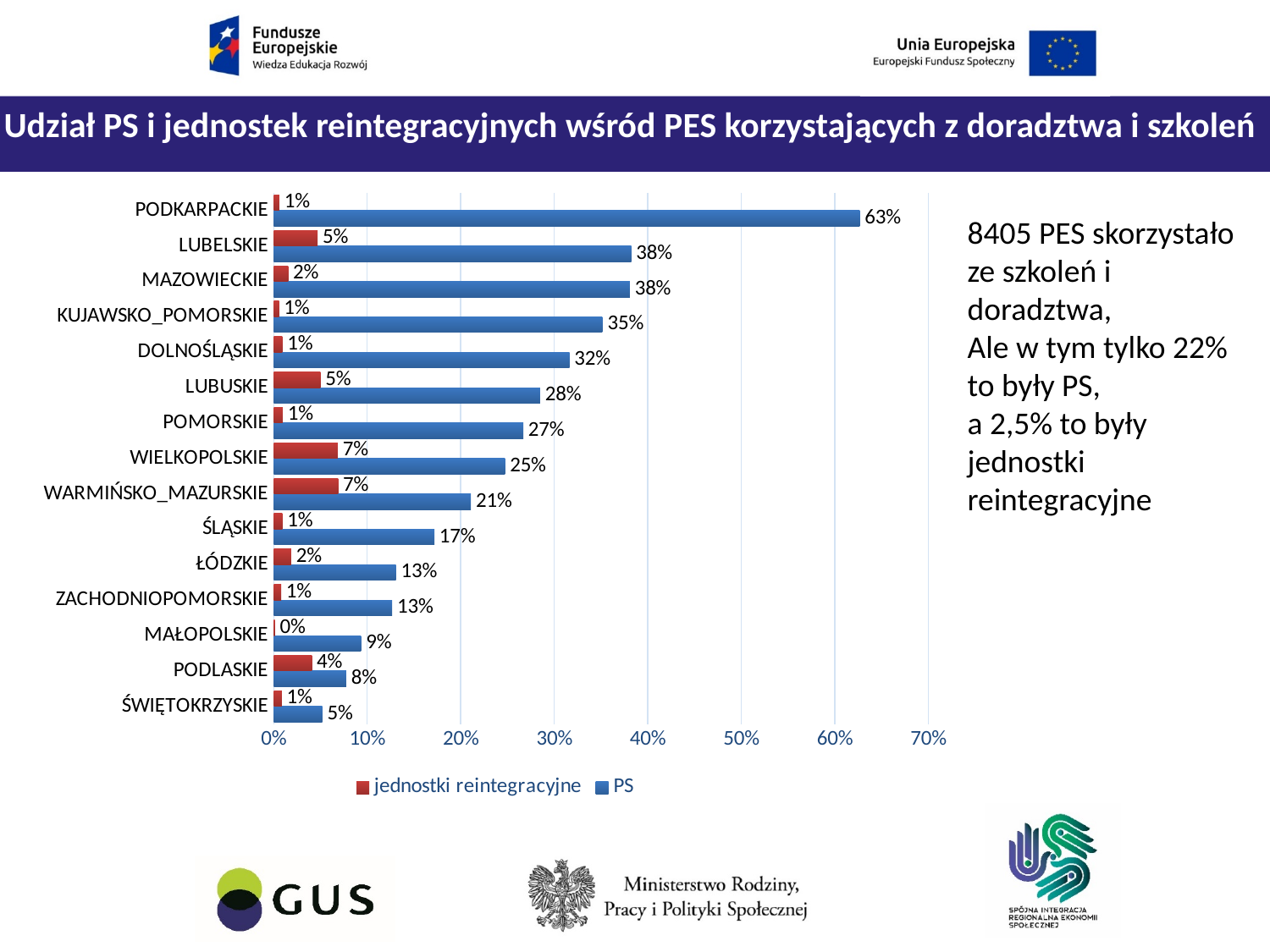
Which region has the highest PS value? PODKARPACKIE How many series does the legend list? 2 What is the difference between the PS values for PODKARPACKIE and LUBELSKIE? 25 percentage points What is the value for jednostki reintegracyjne in WIELKOPOLSKIE? 7% What is the PS value for PODKARPACKIE? 63% Which colour represents the PS series in the chart? Blue What is the PS value for ŚWIĘTOKRZYSKIE? 5% Which region has the lowest value for jednostki reintegracyjne? MAŁOPOLSKIE How many regions are shown on the chart? 15 Which region has the lowest PS value? ŚWIĘTOKRZYSKIE Which has a larger PS value, WIELKOPOLSKIE or ŚLĄSKIE? WIELKOPOLSKIE What kind of chart is shown on the slide? Bar chart